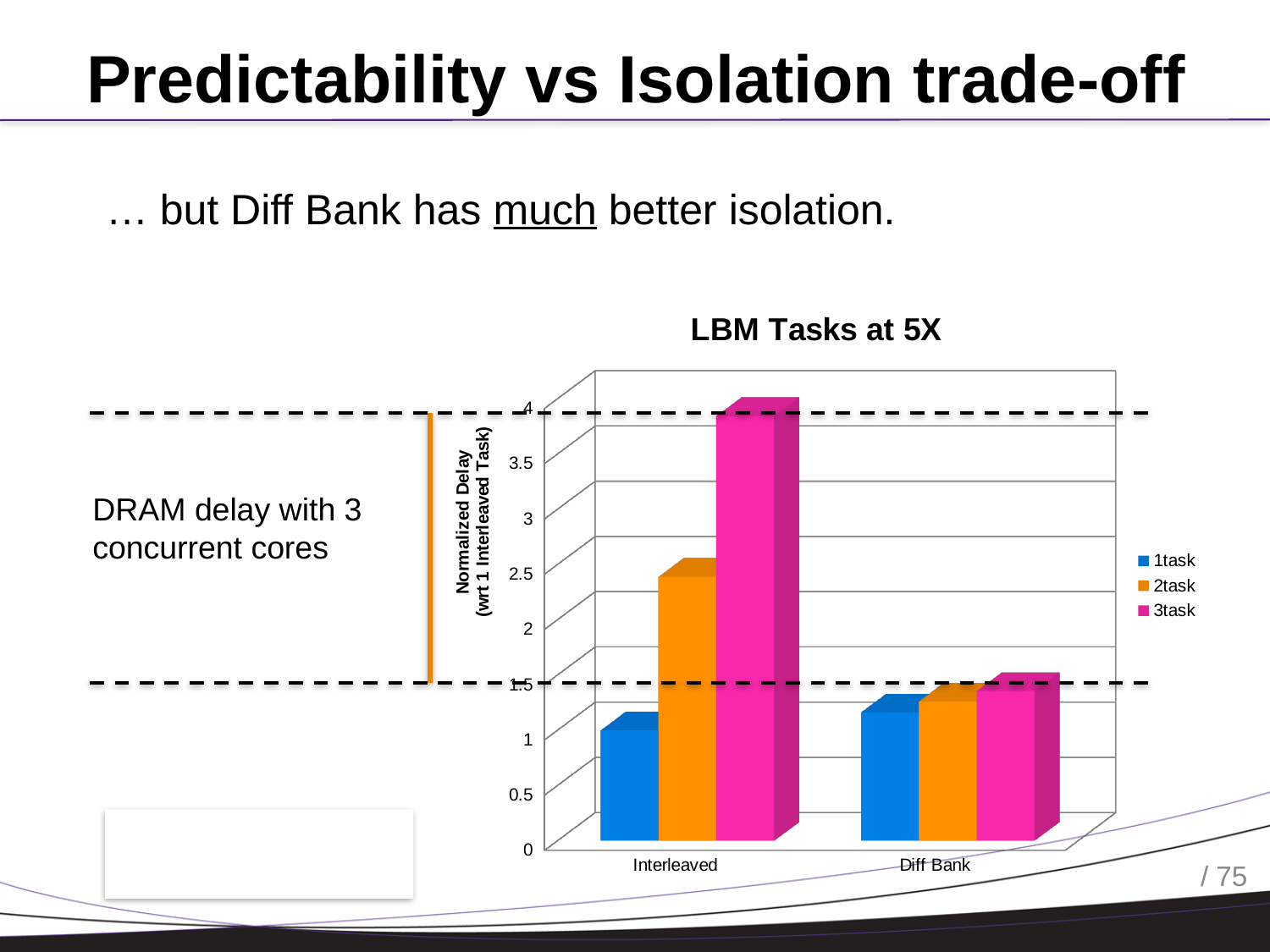
Which is larger, the 3task value for Interleaved or the 3task value for Diff Bank? Interleaved Is the 2task value for Diff Bank greater or less than 2? less How many series does the chart legend list? 3 Is the 3task value for Interleaved greater or less than 3.5? greater What is the label of the vertical axis? Normalized Delay (wrt 1 Interleaved Task) How many categories are shown on the x axis of the chart? 2 What is the title of the chart? LBM Tasks at 5X Which category has the highest 3task bar? Interleaved What kind of chart is shown on the slide? bar chart Which series has the lowest bar in the Interleaved category? 1task Is the 2task value for Interleaved greater or less than 2? greater